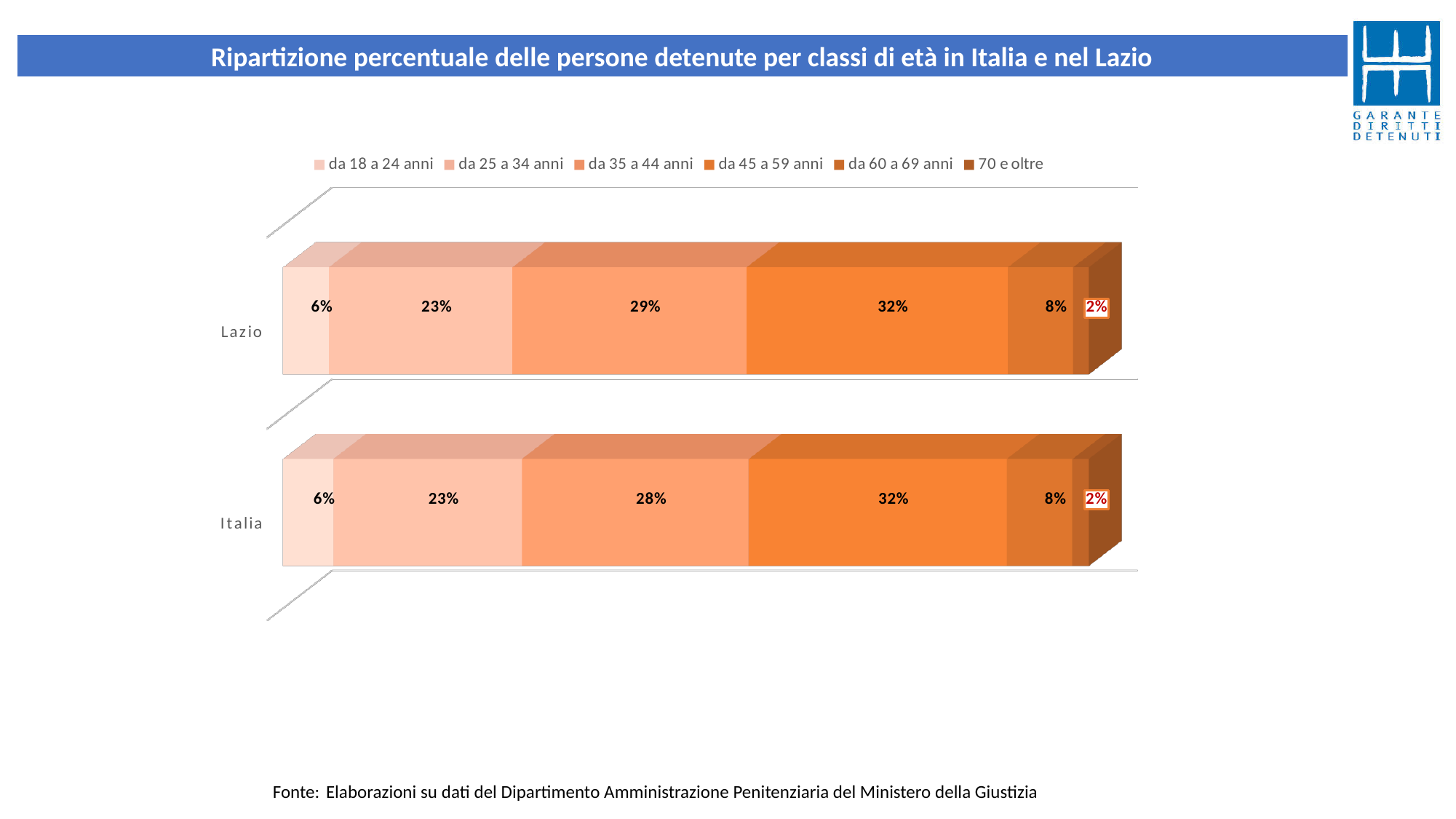
Which age class has the largest share of detainees in Italia? da 45 a 59 anni What percentage of detainees in Lazio are aged 35 to 44 (da 35 a 44 anni)? 29% What is the value for the 'da 45 a 59 anni' segment in the Lazio bar? 32% What kind of chart is shown on the slide? Stacked bar chart What is the difference between the 'da 35 a 44 anni' share in Lazio and in Italia? 1% How many categories (bars) are shown on the chart? 2 What is the value for the '70 e oltre' segment in the Lazio bar? 2% What is the value for the 'da 60 a 69 anni' segment in the Italia bar? 8% Which is larger in Lazio: the 'da 25 a 34 anni' share or the 'da 35 a 44 anni' share? da 35 a 44 anni Which age class has the smallest share of detainees in Lazio? 70 e oltre How many series does the legend list? 6 What percentage of detainees in Italia are aged 35 to 44 (da 35 a 44 anni)? 28%